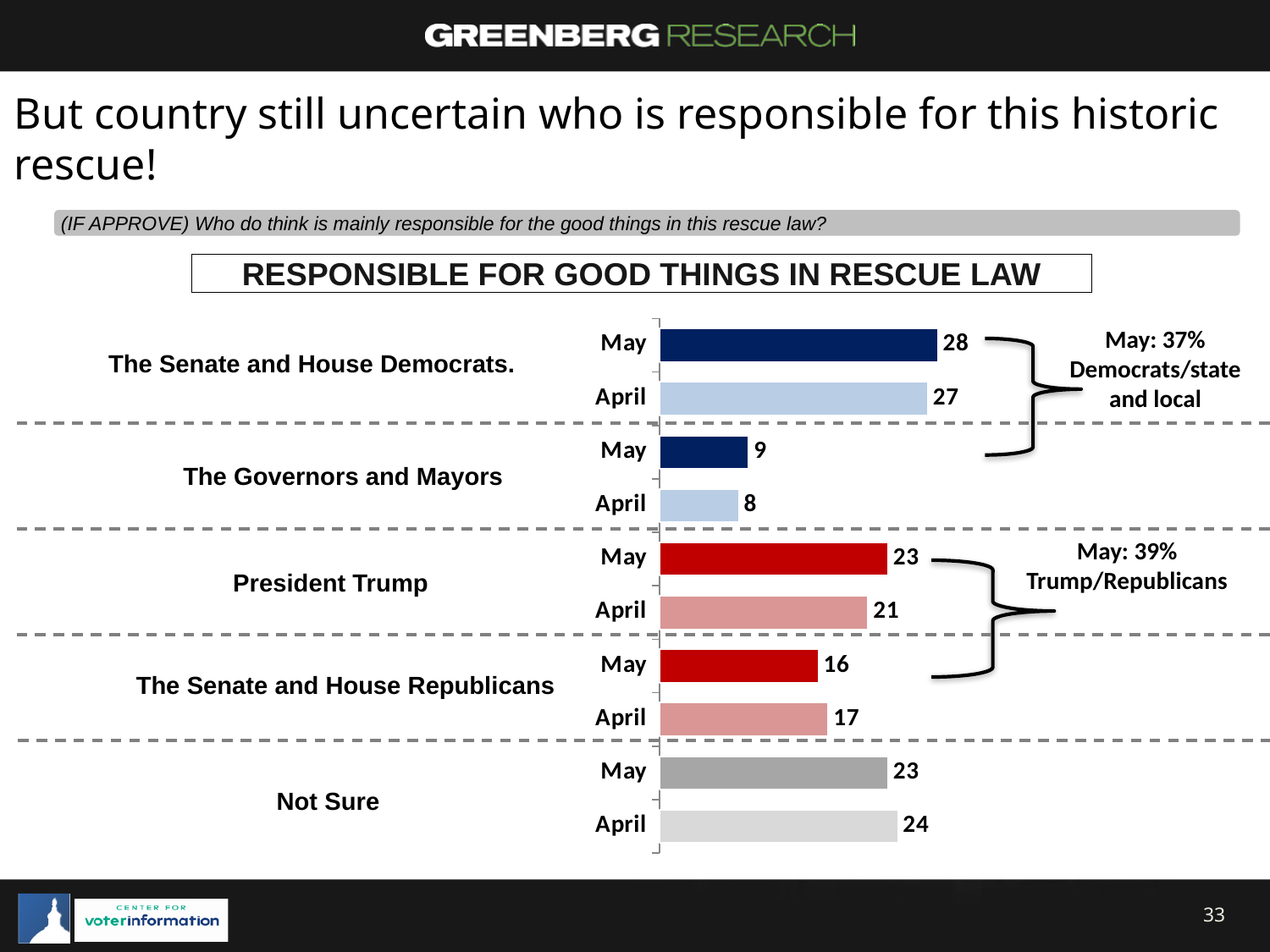
What is the May value for President Trump? 23 Which is larger for Not Sure, the May value or the April value? April What is the May value for The Senate and House Democrats? 28 Which category has the highest May value? The Senate and House Democrats What combined May percentage does the annotation give for Trump/Republicans? 39% What is the April value for The Governors and Mayors? 8 What kind of chart is shown on the slide? Bar chart What is the April value for The Senate and House Republicans? 17 What is the title of the chart? RESPONSIBLE FOR GOOD THINGS IN RESCUE LAW What is the difference between the May and April values for President Trump? 2 How many categories are shown in the chart? 5 Which category has the lowest April value? The Governors and Mayors